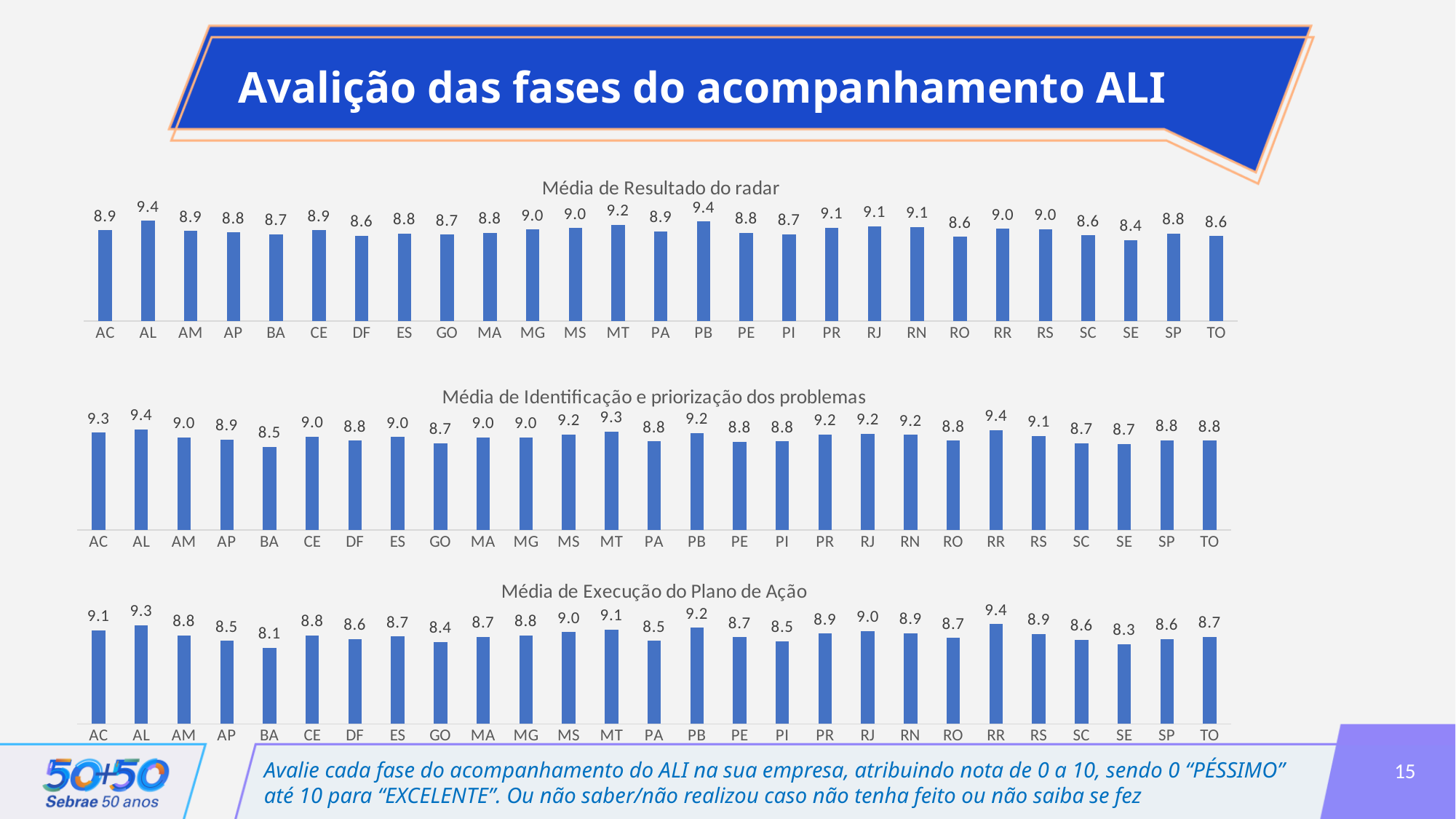
In the 'Média de Execução do Plano de Ação' chart, which state has the highest value? RR In the 'Média de Execução do Plano de Ação' chart, which state has the lowest value? BA In the 'Média de Identificação e priorização dos problemas' chart, which is larger, the value for AC or the value for GO? AC In the 'Média de Execução do Plano de Ação' chart, what is the difference between the values for RR and BA? 1.3 What type of chart is the 'Média de Execução do Plano de Ação' chart? Bar chart In the 'Média de Resultado do radar' chart, what is the value for MT? 9.2 In the 'Média de Resultado do radar' chart, which state has the lowest value? SE In the 'Média de Resultado do radar' chart, what is the difference between the values for AL and SE? 1.0 In the 'Média de Execução do Plano de Ação' chart, what is the value for PB? 9.2 How many states are shown in the 'Média de Resultado do radar' chart? 27 In the 'Média de Identificação e priorização dos problemas' chart, which state has the lowest value? BA In the 'Média de Identificação e priorização dos problemas' chart, what is the value for BA? 8.5